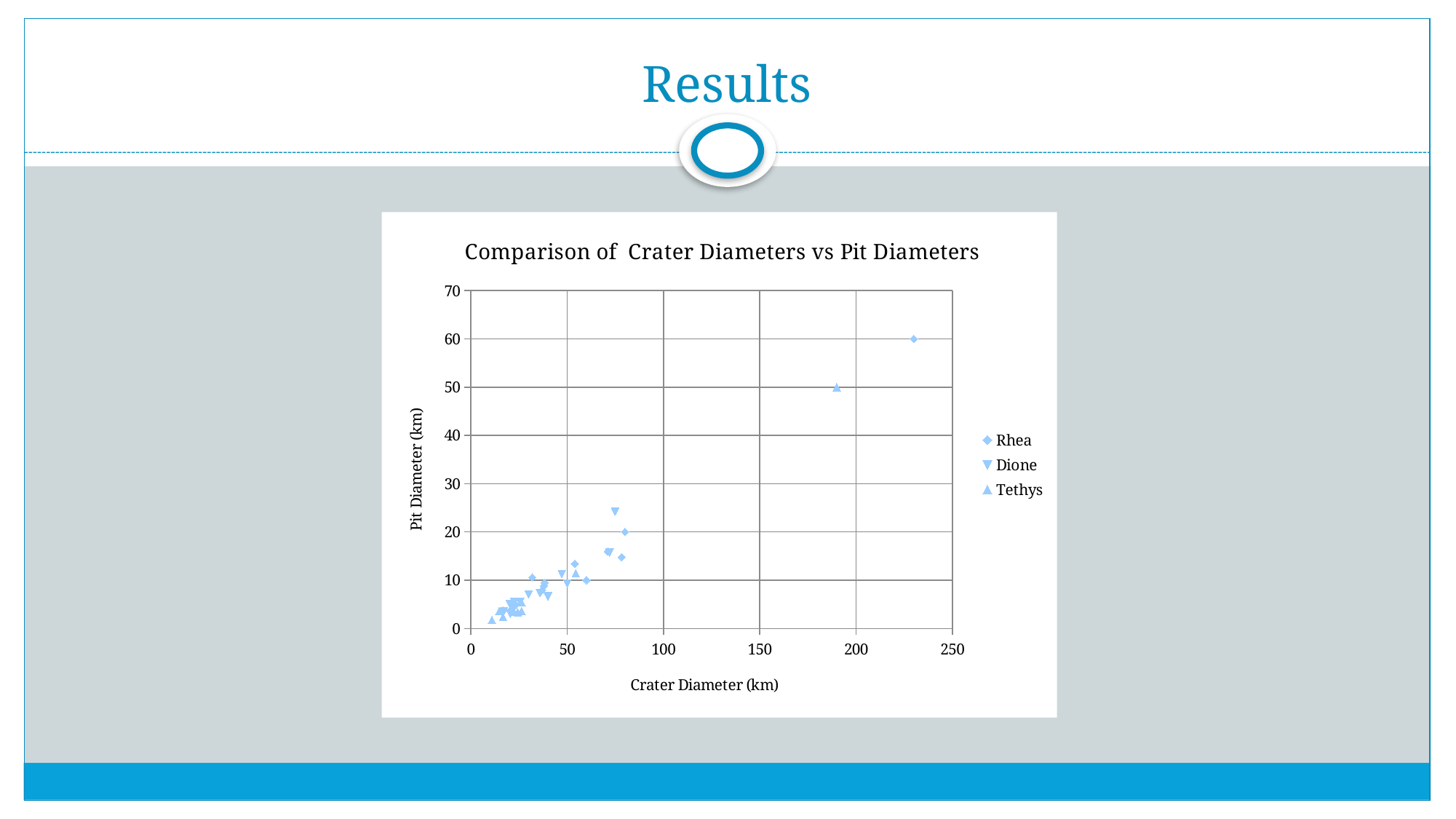
What is the label of the x axis? Crater Diameter (km) What is the title of the chart? Comparison of Crater Diameters vs Pit Diameters Is the crater diameter of the highest Tethys point greater or less than 150? greater What kind of chart is shown on the slide? scatter chart How many series does the legend list? 3 Is the largest crater diameter among the Dione points greater or less than 100? less Is the largest pit diameter among the Dione points greater or less than 30? less Do pit diameters generally rise or fall as crater diameter increases? rise Which series contains the point with the largest pit diameter? Rhea Which series contains the point with the largest crater diameter? Rhea